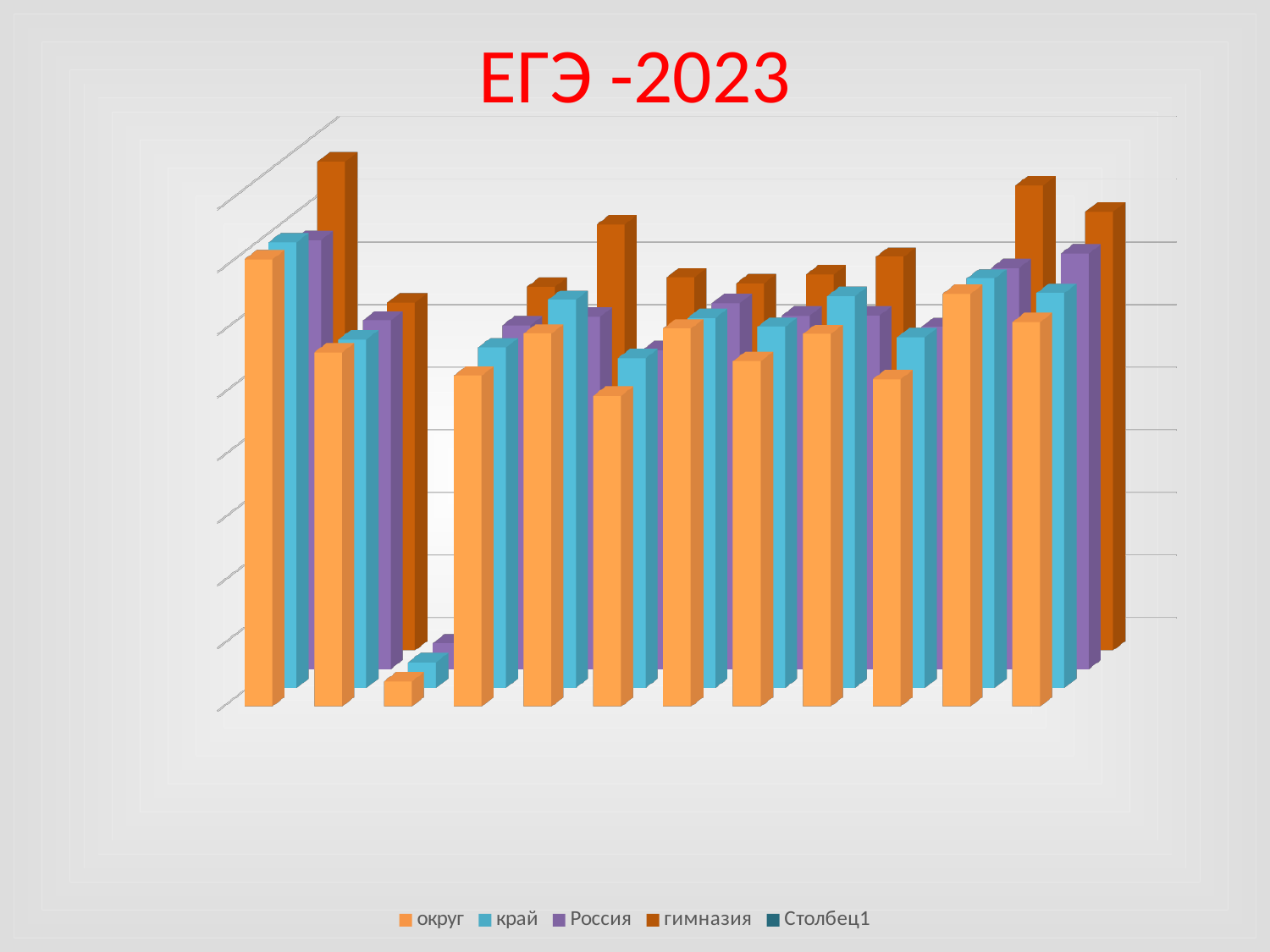
What is the title of the chart? ЕГЭ -2023 Which series is shown in dark orange in the legend? гимназия How many groups of bars (categories) are plotted in the chart? 12 What kind of chart is shown on the slide? bar chart How many series does the legend list? 5 Which series has the tallest bar in the chart? гимназия